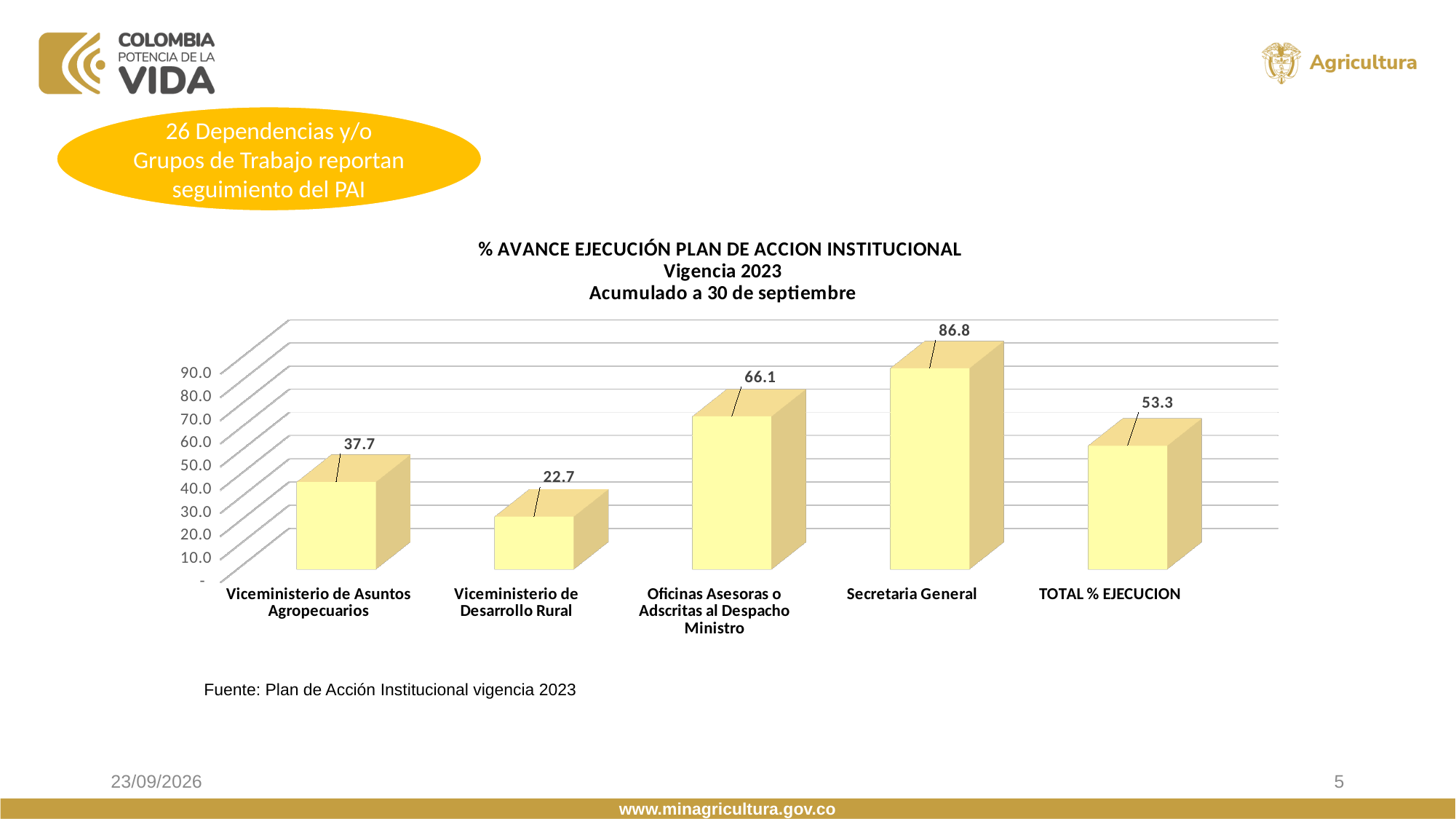
Is the value for Viceministerio de Asuntos Agropecuarios greater or less than 50.0? less Which is larger, the value for Oficinas Asesoras o Adscritas al Despacho Ministro or the value for TOTAL % EJECUCION? Oficinas Asesoras o Adscritas al Despacho Ministro Which category has the highest value? Secretaria General How many categories are shown on the x axis? 5 What is the value for Oficinas Asesoras o Adscritas al Despacho Ministro? 66.1 Which category has the lowest value? Viceministerio de Desarrollo Rural What is the value for Viceministerio de Desarrollo Rural? 22.7 What is the difference between the values for Secretaria General and Viceministerio de Asuntos Agropecuarios? 49.1 What is the value for TOTAL % EJECUCION? 53.3 What kind of chart is shown on the slide? bar chart What is the first line of the chart title? % AVANCE EJECUCIÓN PLAN DE ACCION INSTITUCIONAL What is the value for Secretaria General? 86.8